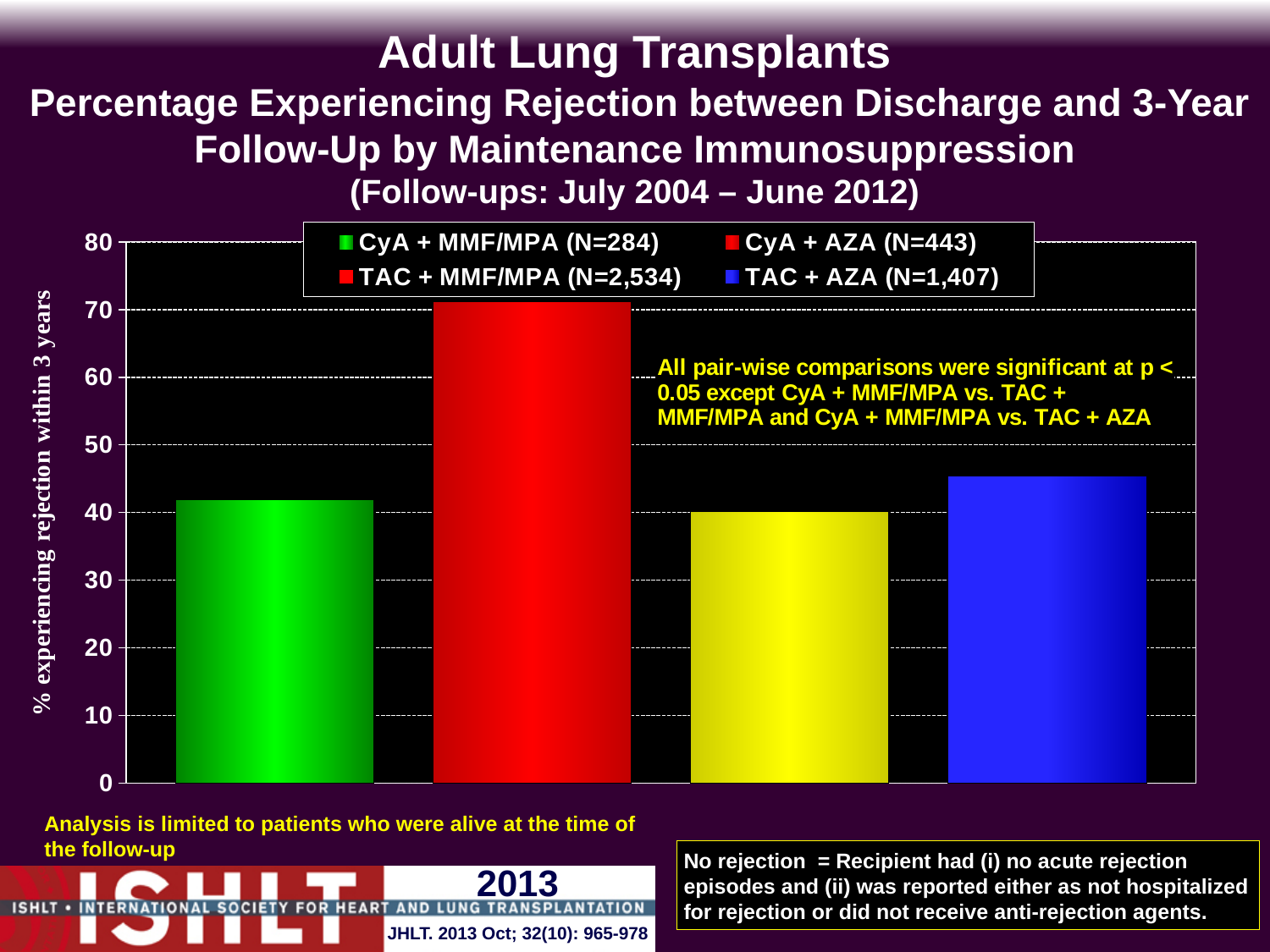
Which maintenance immunosuppression group has the lowest percentage experiencing rejection within 3 years? TAC + MMF/MPA Is the value for CyA + MMF/MPA greater or less than 40? greater What is the N for the TAC + MMF/MPA group shown in the legend? N=2,534 Which maintenance immunosuppression group has the highest percentage experiencing rejection within 3 years? CyA + AZA Which is larger, the value for TAC + AZA or the value for TAC + MMF/MPA? TAC + AZA How many series does the legend list? 4 Which is larger, the value for CyA + AZA or the value for TAC + AZA? CyA + AZA What kind of chart is shown on the slide? bar chart What is the label on the y axis of the chart? % experiencing rejection within 3 years Is the value for CyA + AZA greater or less than 70? greater How many bars are plotted in the chart? 4 Is the value for TAC + AZA greater or less than 50? less